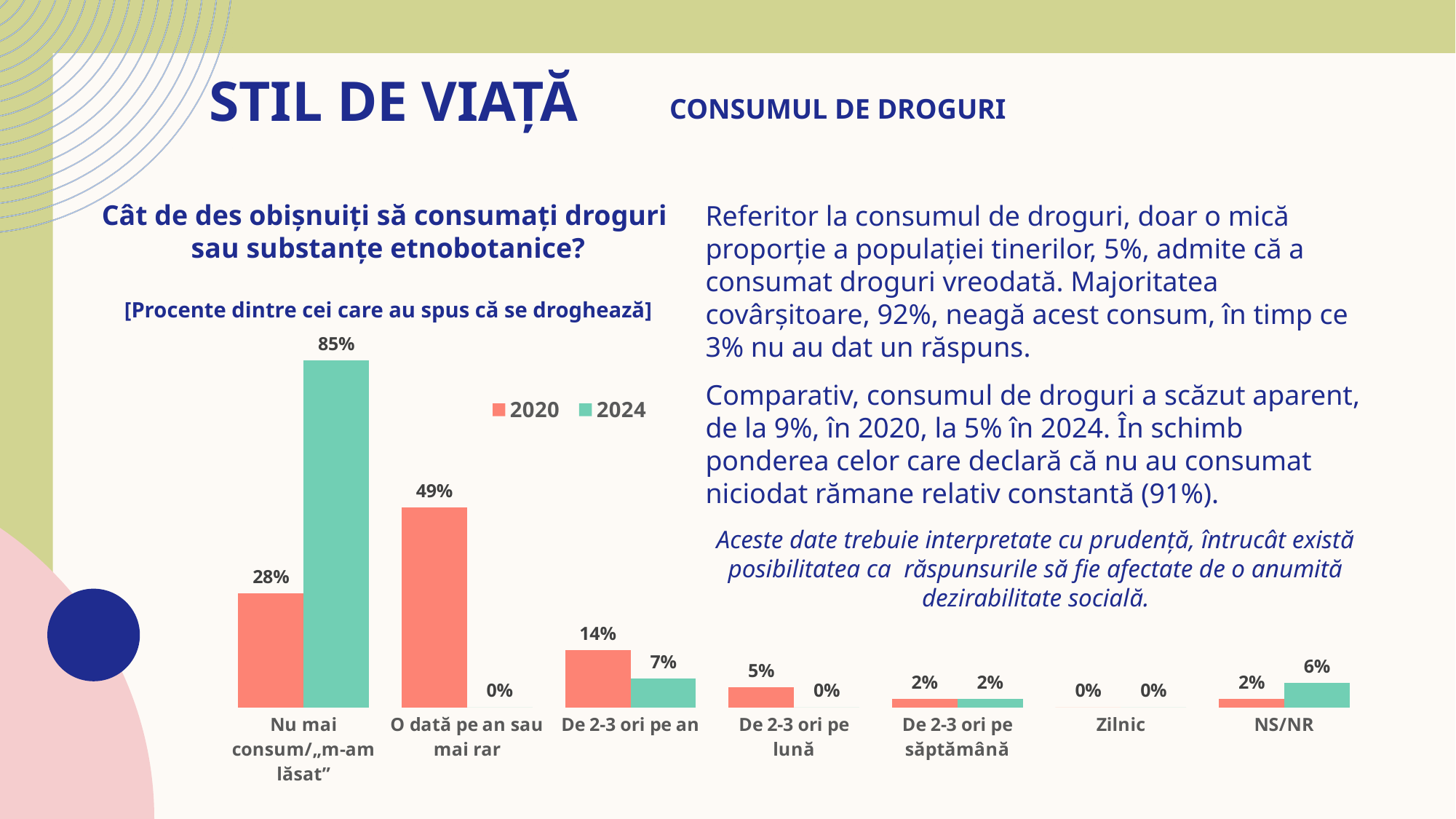
Which category has the highest 2024 value? Nu mai consum/„m-am lăsat” What is the 2024 value for "De 2-3 ori pe an"? 7% Which is larger for "De 2-3 ori pe an": the 2020 value or the 2024 value? 2020 How many categories are shown on the x axis of the chart? 7 What is the 2024 value for "Nu mai consum/„m-am lăsat”"? 85% How many series does the legend list? 2 Which category has the highest 2020 value? O dată pe an sau mai rar What is the 2020 value for "De 2-3 ori pe lună"? 5% What is the difference between the 2024 and 2020 values for "Nu mai consum/„m-am lăsat”"? 57% What kind of chart is shown on the slide? Bar chart What is the 2024 value for "NS/NR"? 6% What is the 2020 value for "O dată pe an sau mai rar"? 49%